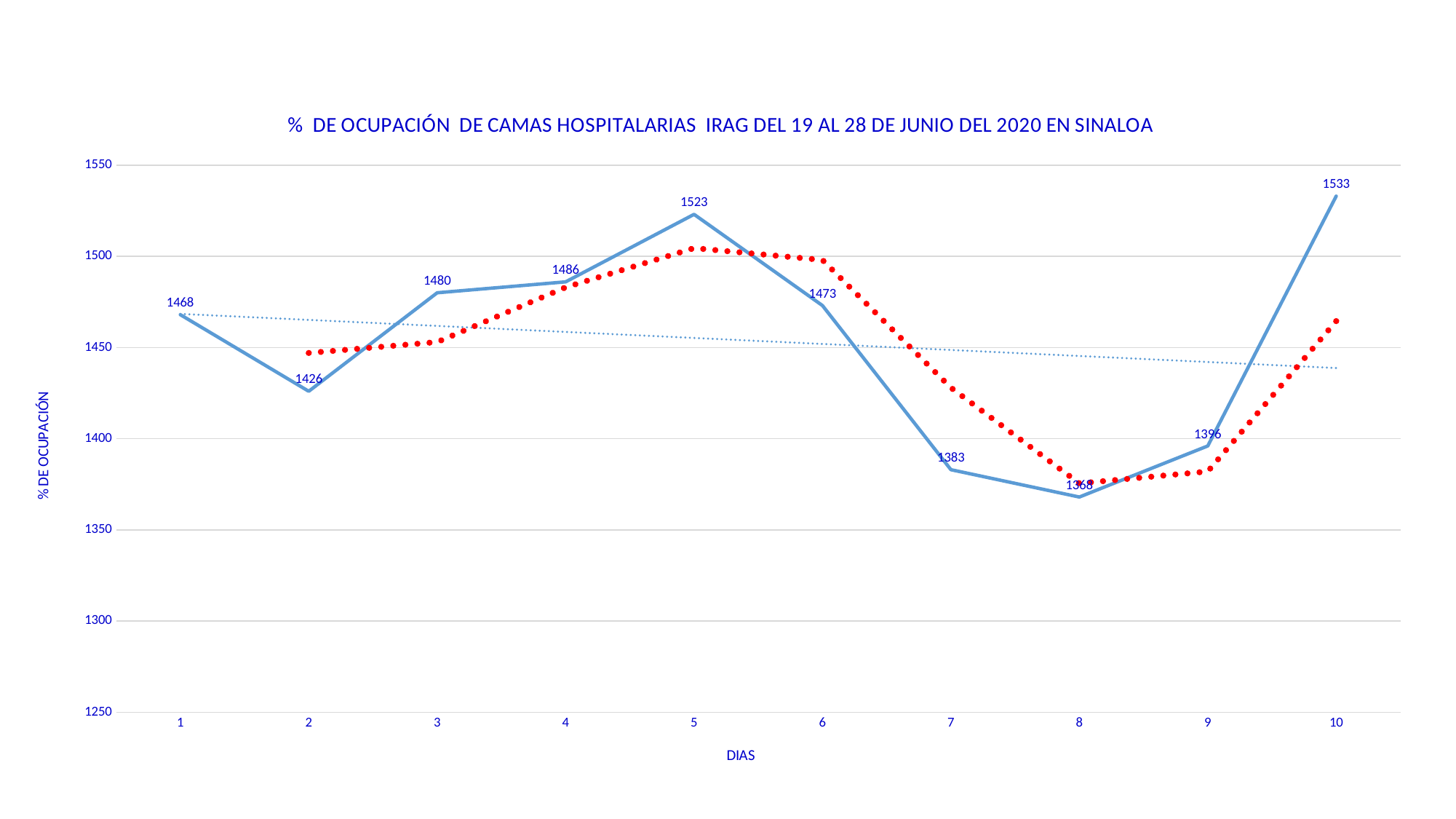
What is the difference between the values for day 3 and day 2? 54 What is the value for day 1? 1468 How many days are plotted on the x axis? 10 What is the value for day 10? 1533 Which day has the highest value? Day 10 Which is larger, the value for day 4 or the value for day 6? Day 4 What is the value for day 7? 1383 Which day has the lowest value? Day 8 What is the label of the x axis? DIAS What is the difference between the values for day 10 and day 5? 10 What kind of chart is this? Line chart What is the value for day 5? 1523